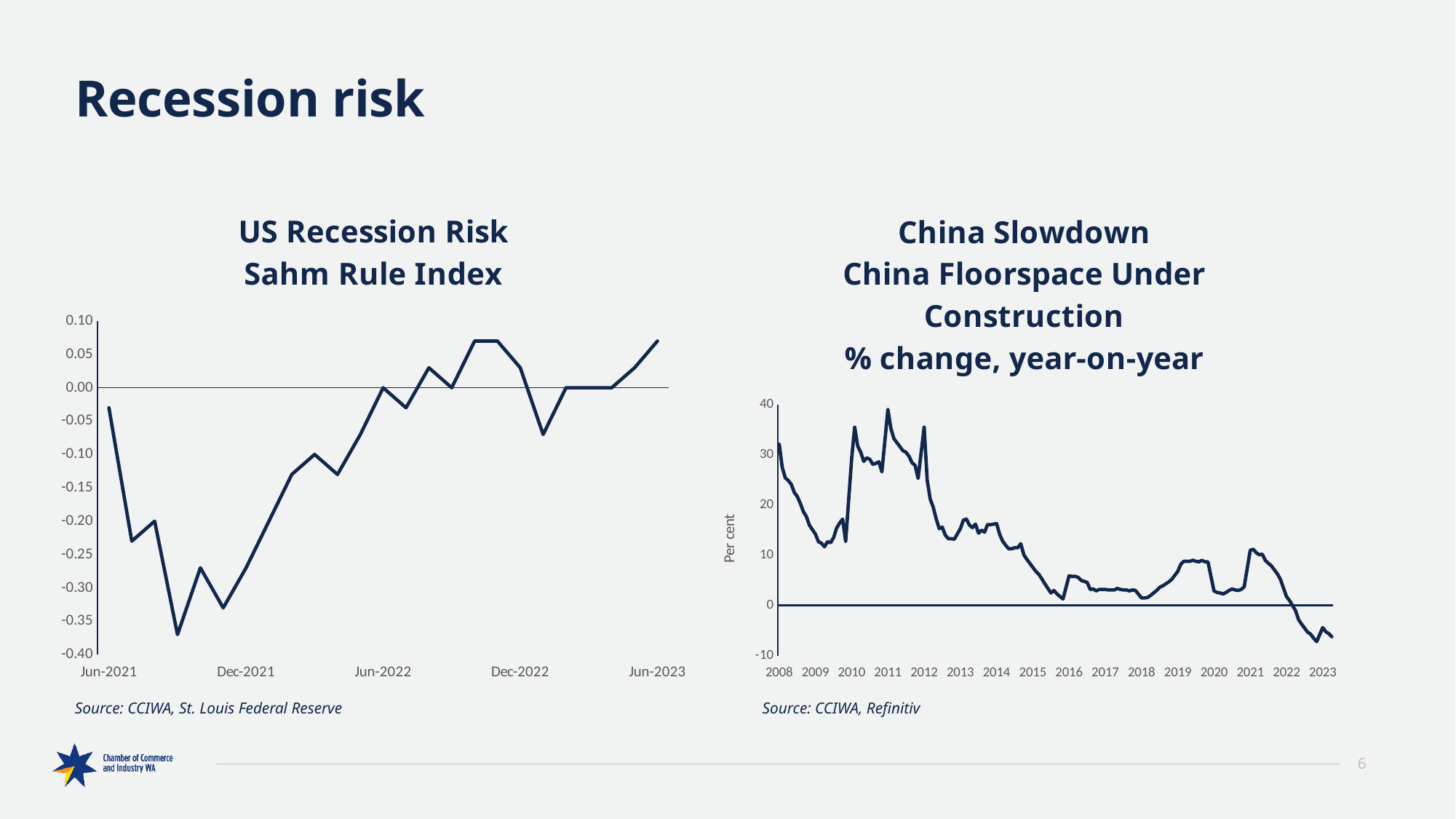
In the China Floorspace Under Construction chart, is the value at the end of the line in 2023 greater or less than 0? less What kind of chart is the US Recession Risk Sahm Rule Index chart on the left? line chart In the US Recession Risk Sahm Rule Index chart, is the value at Jun-2023 greater or less than 0.00? greater In the US Recession Risk Sahm Rule Index chart, does the index overall rise or fall between Jun-2021 and Jun-2023? rise What is the y-axis label on the China Floorspace Under Construction chart? Per cent In the China Floorspace Under Construction chart, does the year-on-year % change overall rise or fall from 2008 to 2023? fall In the US Recession Risk Sahm Rule Index chart, is the value at Jun-2021 greater or less than 0.00? less What kind of chart is the China Floorspace Under Construction chart on the right? line chart How many year labels are shown on the x axis of the China Floorspace Under Construction chart? 16